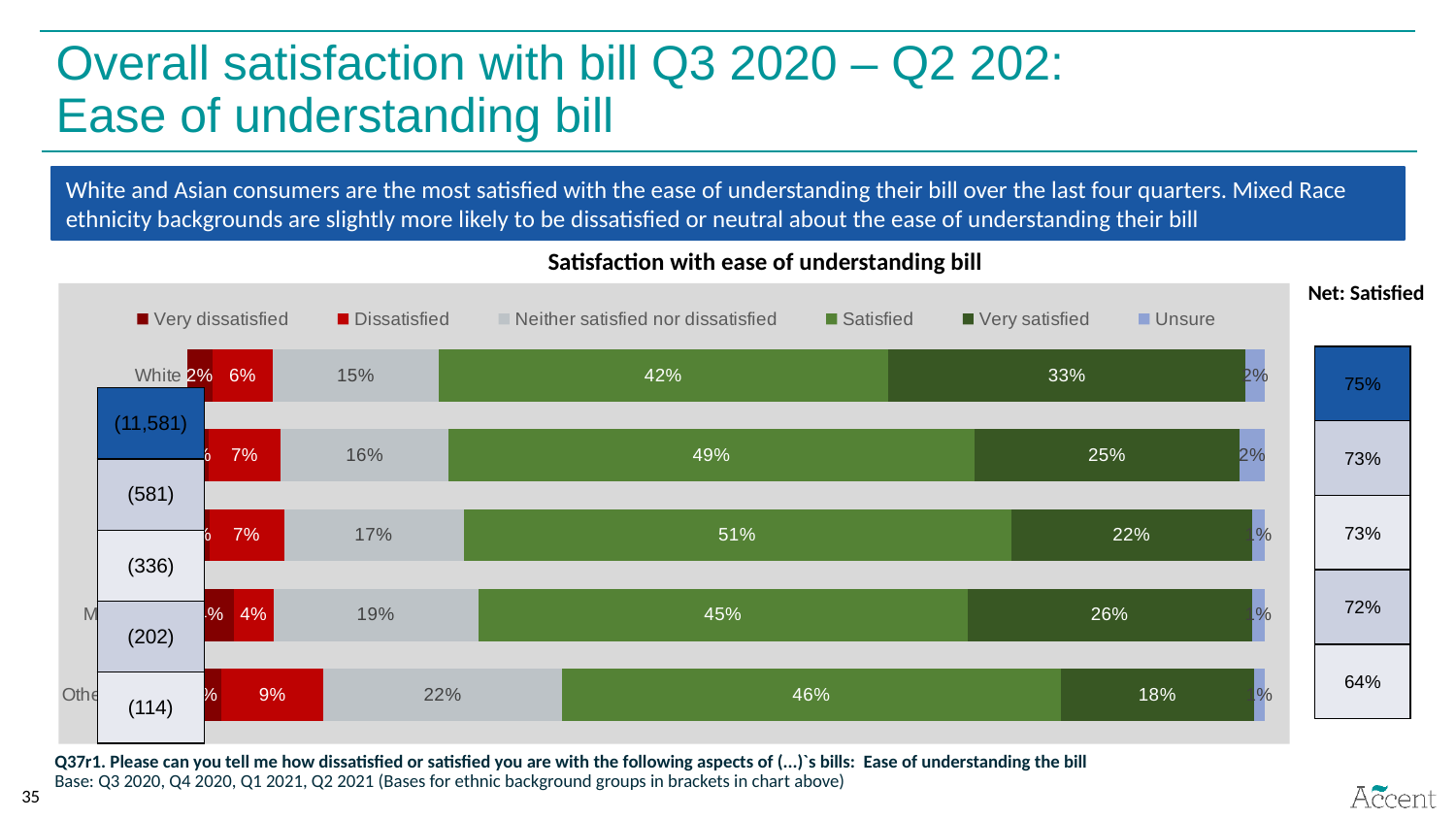
What type of chart is shown on the slide? Bar chart Which group has the lowest Net: Satisfied score? Other What is the 'Very satisfied' value for the Other group? 18% What is the 'Dissatisfied' value for the Other group? 9% Which group has the highest Net: Satisfied score? White Which group has the larger 'Satisfied' value, White or Other? Other What percentage of White consumers are 'Satisfied' with the ease of understanding their bill? 42% What percentage of White consumers are 'Very satisfied' with the ease of understanding their bill? 33% How many ethnic background groups (bars) are shown in the chart? 5 What is the difference in percentage points between the 'Satisfied' and 'Very satisfied' values for White consumers? 9 percentage points What is the 'Neither satisfied nor dissatisfied' value for the Other group? 22% How many series does the legend of the chart list? 6